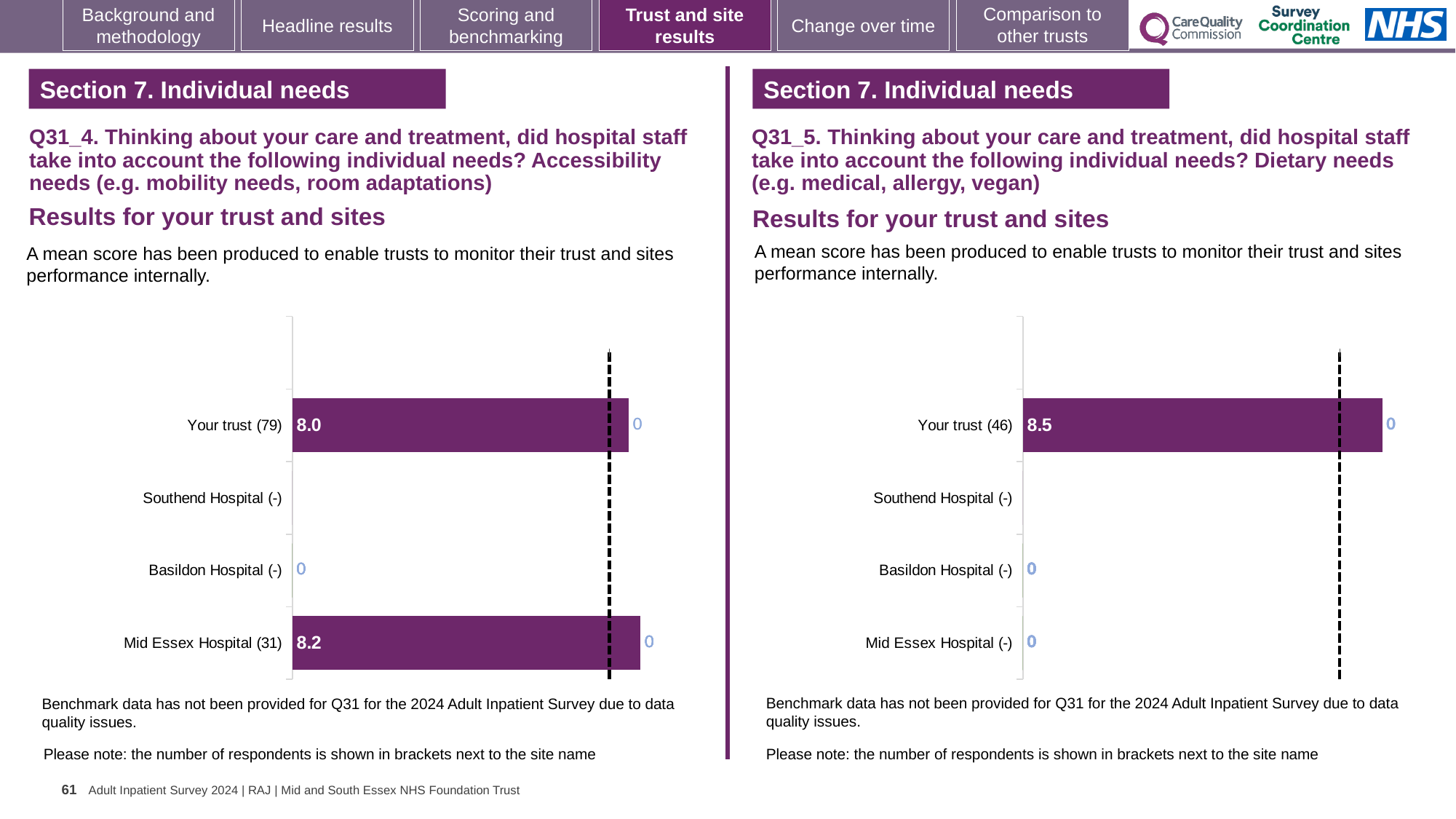
How many categories are listed on the y axis of the Q31_5 Dietary needs chart? 4 In the Q31_4 Accessibility needs chart, which is larger: the score for Your trust or the score for Mid Essex Hospital? Mid Essex Hospital In the Q31_5 Dietary needs chart, what is the mean score for Your trust? 8.5 In the Q31_4 Accessibility needs chart, which category has the highest mean score? Mid Essex Hospital In the Q31_4 Accessibility needs chart, what is the difference between the Mid Essex Hospital score and the Your trust score? 0.2 In the Q31_4 Accessibility needs chart, how many respondents are shown in brackets for Mid Essex Hospital? 31 In the Q31_4 Accessibility needs chart, what is the mean score for Mid Essex Hospital? 8.2 Which chart shows a higher score for Your trust: the Q31_4 Accessibility needs chart or the Q31_5 Dietary needs chart? Q31_5 Dietary needs chart In the Q31_4 Accessibility needs chart, what is the mean score for Your trust? 8.0 In the Q31_4 Accessibility needs chart, how many respondents are shown in brackets for Your trust? 79 In the Q31_5 Dietary needs chart, how many respondents are shown in brackets for Your trust? 46 What kind of chart is used in the Q31_4 Accessibility needs chart? Bar chart